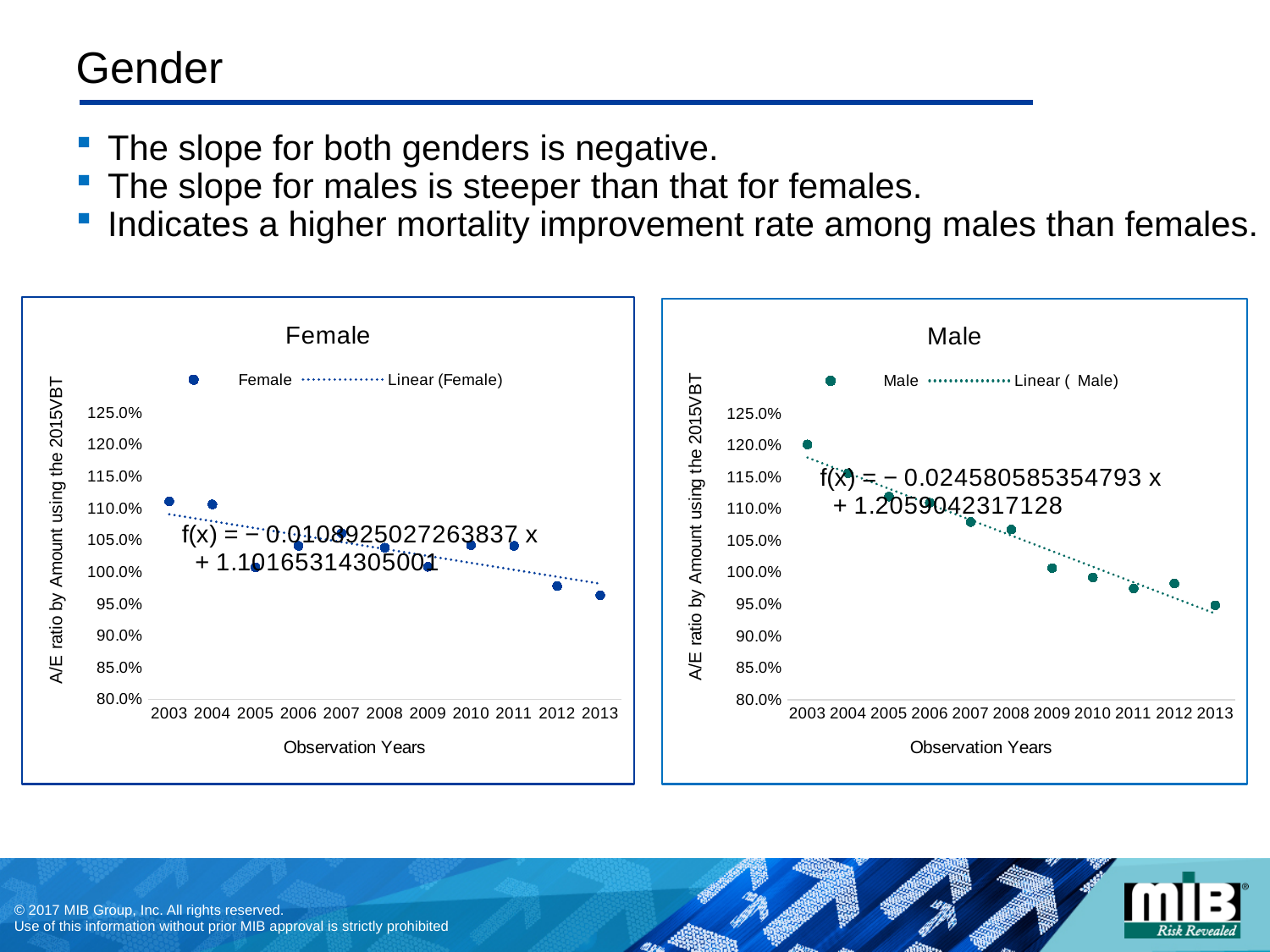
In the Male chart, is the value for 2013 greater or less than 100.0%? less How many entries does the legend of the Female chart list? 2 In the Male chart, do the A/E ratio values generally rise or fall from 2003 to 2013? fall What kind of chart is the Female chart? scatter chart In the Male chart, is the value for 2003 greater or less than 115.0%? greater In the Female chart, which is larger, the value for 2004 or the value for 2012? 2004 In the Male chart, which observation year has the highest A/E ratio? 2003 What is the label of the y axis on the Male chart? A/E ratio by Amount using the 2015VBT In the Female chart, is the value for 2003 greater or less than 110.0%? greater In the Male chart, which observation year has the lowest A/E ratio? 2013 In the Male chart, how many observation years are shown on the x axis? 11